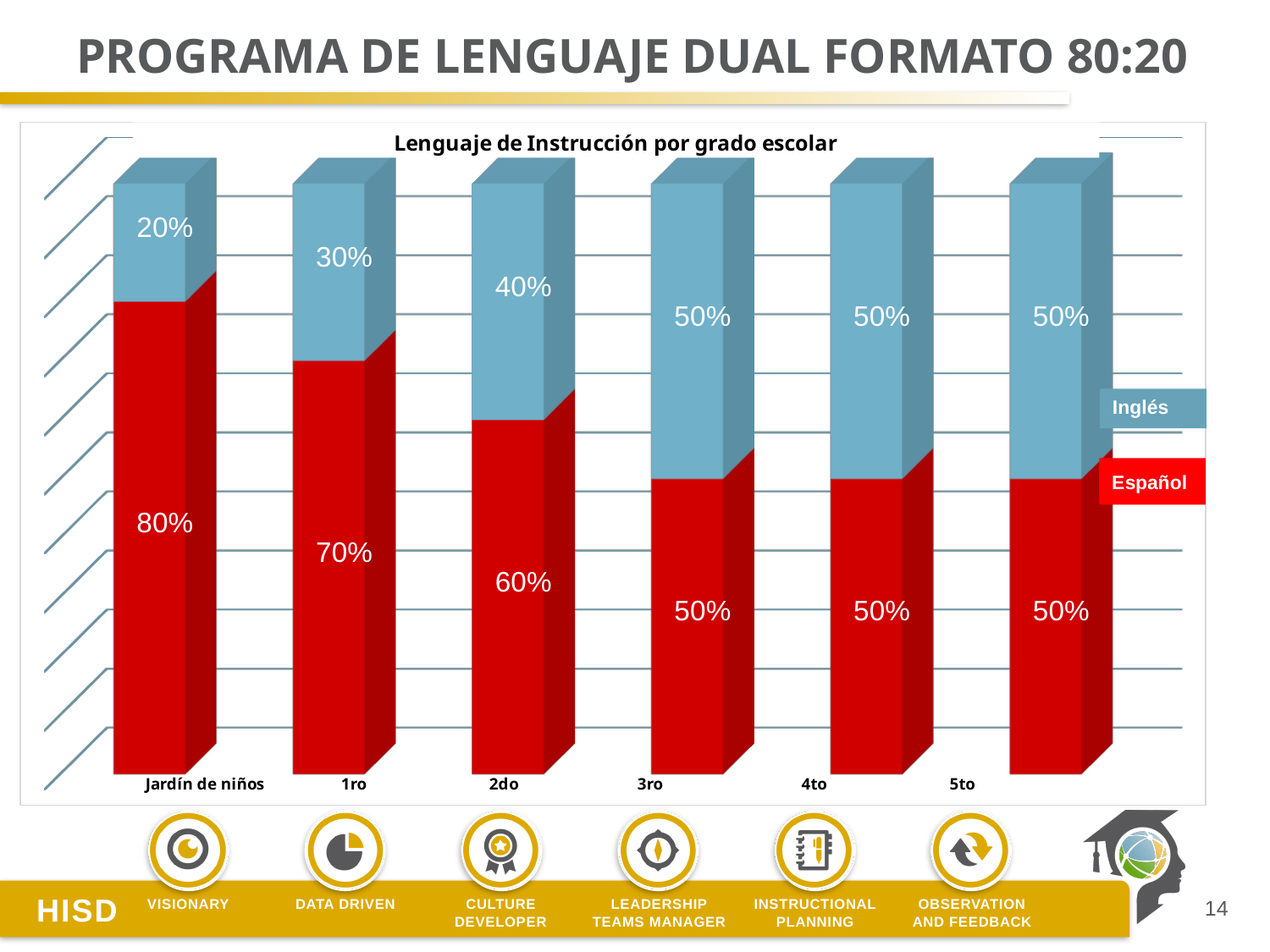
What is the Inglés value for 4to? 50% What is the title of the chart? Lenguaje de Instrucción por grado escolar How many series does the legend list? 2 Which is larger for 2do, the Español value or the Inglés value? Español What is the Español value for Jardín de niños? 80% What is the difference between the Español and Inglés values for 1ro? 40% How many grade categories are shown on the x axis? 6 What is the Inglés value for 2do? 40% Which grade has the lowest Inglés value? Jardín de niños Which grade has the highest Español value? Jardín de niños What kind of chart is shown? Stacked bar chart What is the Español value for 1ro? 70%